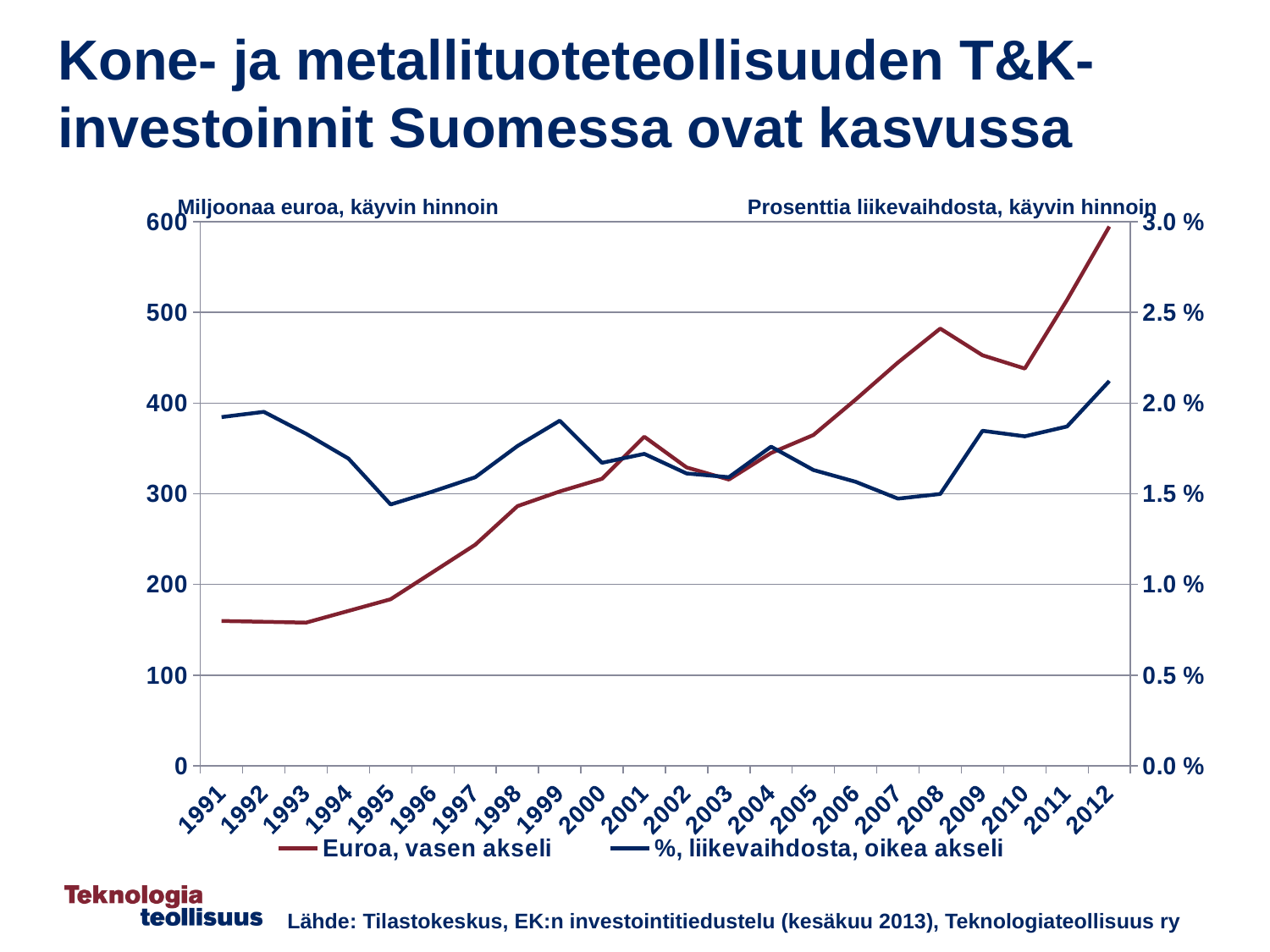
How many years are shown on the x axis? 22 Is the value for '%, liikevaihdosta, oikea akseli' in 2012 greater or less than 2.0 %? greater For the series 'Euroa, vasen akseli', which year has the larger value, 2008 or 2010? 2008 Is the value for 'Euroa, vasen akseli' in 2012 greater or less than 500? greater How many series does the legend list? 2 Is the value for '%, liikevaihdosta, oikea akseli' in 1999 greater or less than 1.5 %? greater What kind of chart is shown on the slide? line chart What is the title of the left vertical axis? Miljoonaa euroa, käyvin hinnoin Does the series 'Euroa, vasen akseli' generally rise or fall from 1991 to 2012? rise What is the title of the right vertical axis? Prosenttia liikevaihdosta, käyvin hinnoin Which year has the highest value for the series 'Euroa, vasen akseli'? 2012